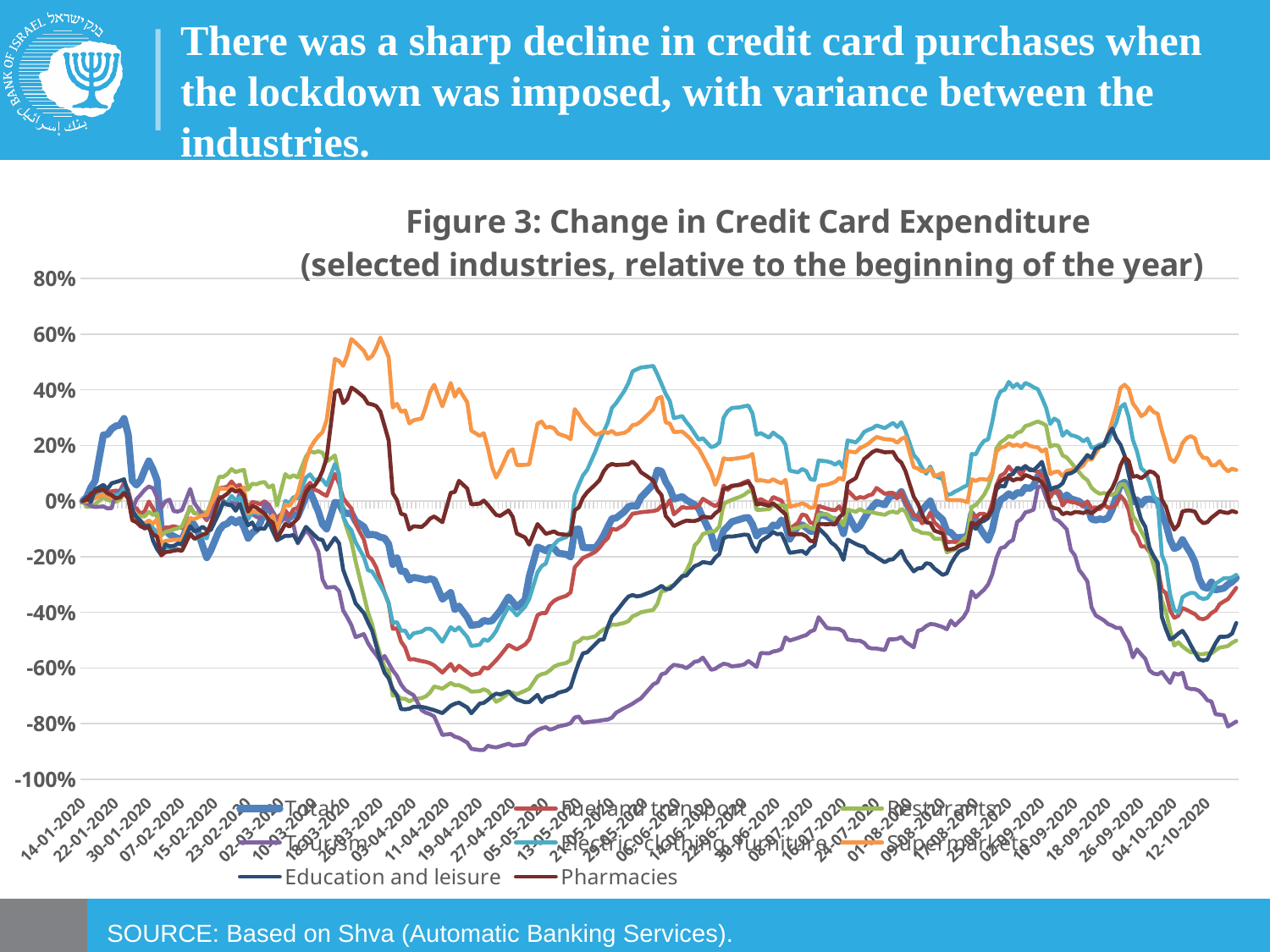
At the last date shown in Figure 3, which series is lower: Tourism or Total? Tourism Is the highest value reached by the Supermarkets series in Figure 3 greater or less than 40%? greater What kind of chart is Figure 3? line chart Is the lowest value reached by the Pharmacies series in Figure 3 greater or less than -40%? greater How many series does the legend of Figure 3 list? 8 Is the lowest value reached by the Tourism series in Figure 3 greater or less than -80%? less Which series in Figure 3 reaches the highest value on the chart? Supermarkets What is the title of the chart on the slide? Figure 3: Change in Credit Card Expenditure (selected industries, relative to the beginning of the year) What is the source cited for the chart on the slide? Based on Shva (Automatic Banking Services) Which series in Figure 3 reaches the lowest value on the chart? Tourism